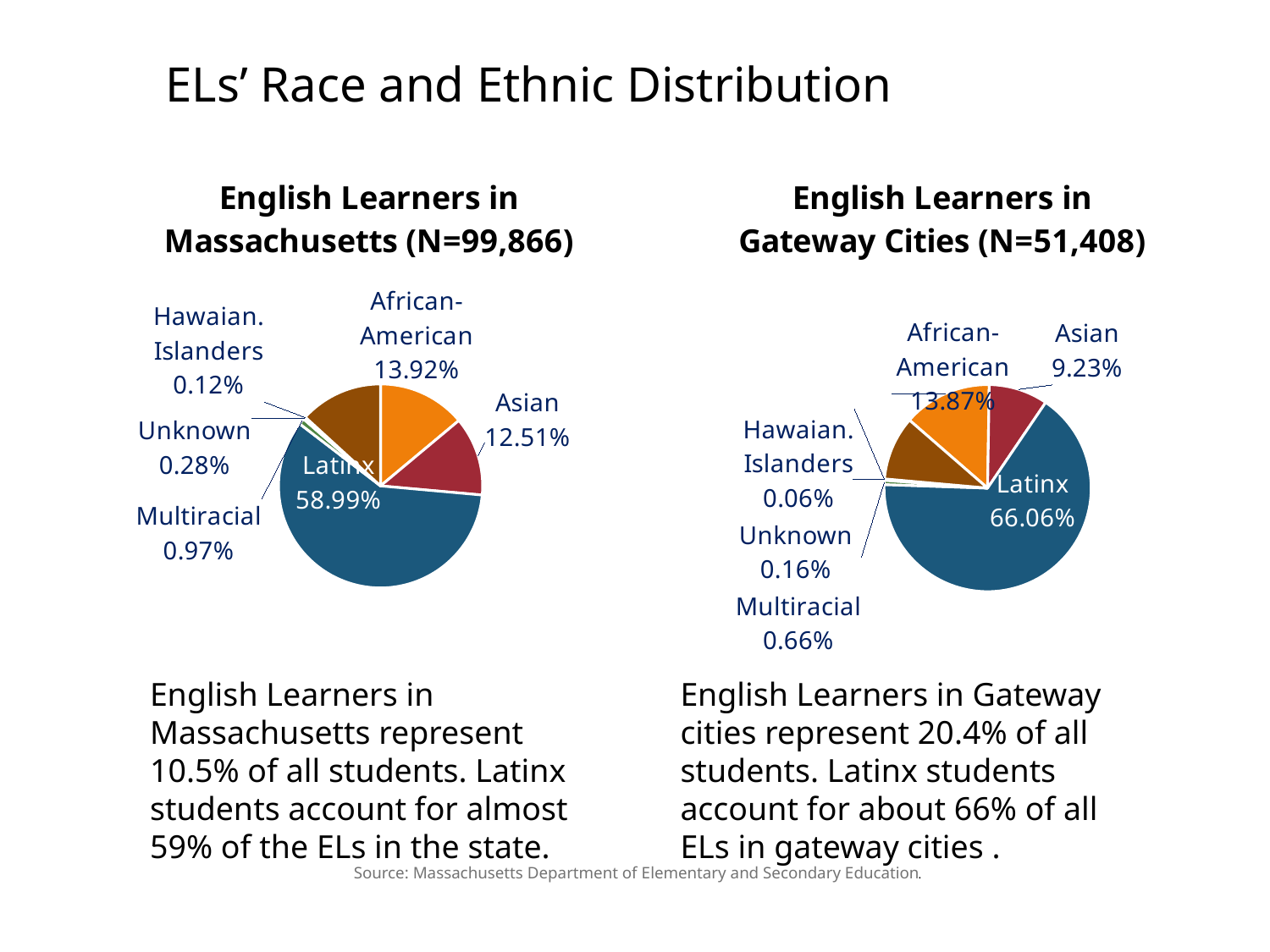
In the English Learners in Massachusetts chart, what share is Latinx? 58.99% In the English Learners in Massachusetts chart, what is the difference between the African-American and Asian shares? 1.41% In the English Learners in Massachusetts chart, what share is African-American? 13.92% In the English Learners in Gateway Cities chart, what share is Latinx? 66.06% In the English Learners in Gateway Cities chart, which is larger, the Multiracial share or the Unknown share? Multiracial In the English Learners in Massachusetts chart, which labeled group has the smallest share? Hawaiian Islanders In the English Learners in Gateway Cities chart, what share is Asian? 9.23% In the English Learners in Massachusetts chart, which labeled group has the largest share? Latinx What kind of chart is used for English Learners in Massachusetts? Pie chart What is the N value shown in the title of the English Learners in Gateway Cities chart? 51,408 In the English Learners in Massachusetts chart, what share is Hawaiian Islanders? 0.12% In the English Learners in Gateway Cities chart, what is the difference between the African-American and Asian shares? 4.64%